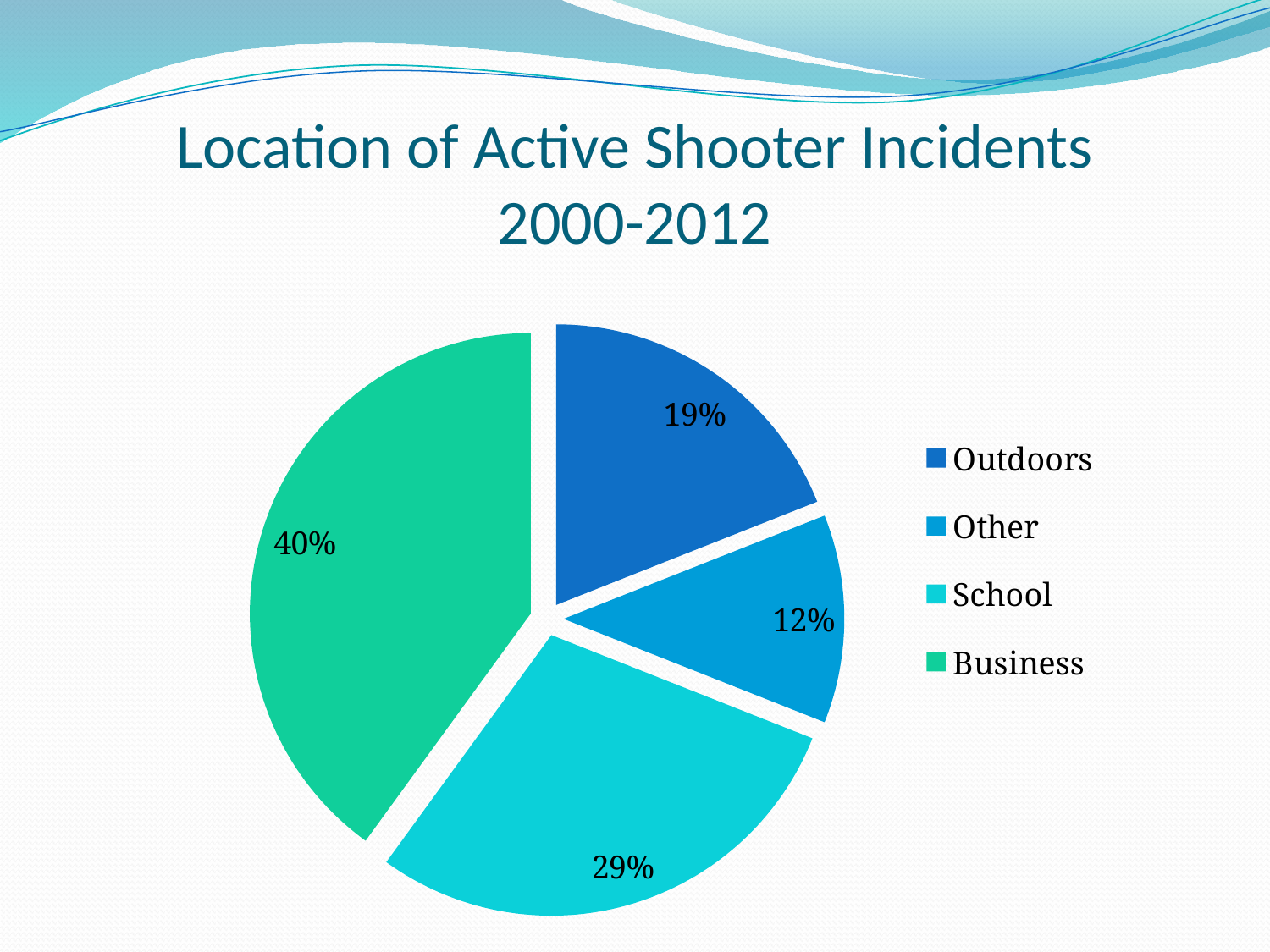
What is the difference in percentage points between the Business and School shares? 11 What is the difference in percentage points between the Outdoors and Other shares? 7 What is the title of the chart? Location of Active Shooter Incidents 2000-2012 What kind of chart is shown on the slide? pie chart What share of active shooter incidents occurred Outdoors? 19% Which location has the largest share of incidents? Business What share of active shooter incidents occurred at a Business? 40% What share of active shooter incidents falls under Other? 12% Which location has the smallest share of incidents? Other How many categories does the pie chart show? 4 Which has a larger share, School or Outdoors? School